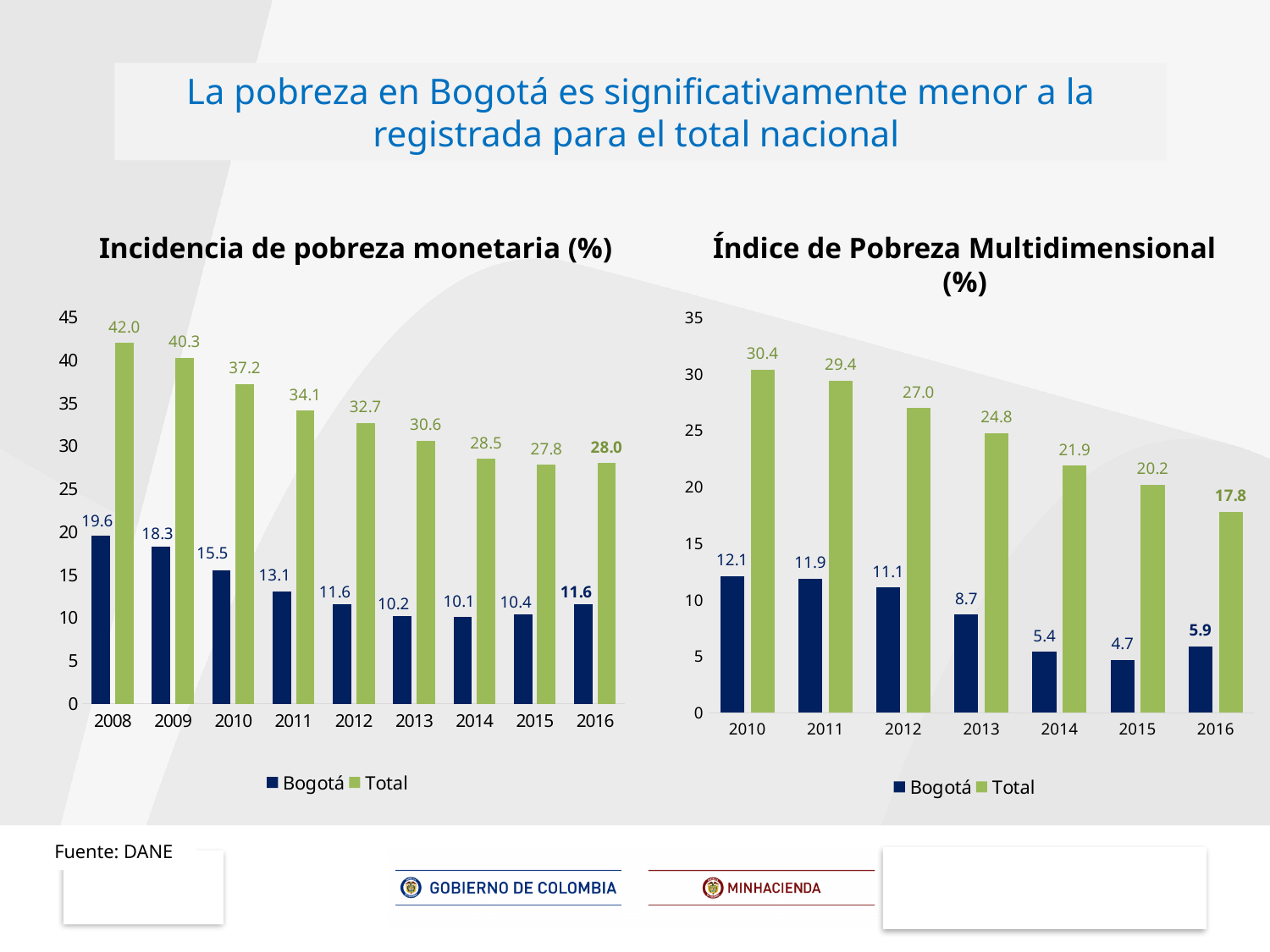
In the 'Incidencia de pobreza monetaria (%)' chart, which year has the highest Total value? 2008 In the 'Incidencia de pobreza monetaria (%)' chart, which year has the lowest Bogotá value? 2014 In the 'Índice de Pobreza Multidimensional (%)' chart, what is the value for Bogotá in 2013? 8.7 In the 'Incidencia de pobreza monetaria (%)' chart, how many years are shown on the x axis? 9 In the 'Incidencia de pobreza monetaria (%)' chart, what is the value for Bogotá in 2008? 19.6 In the 'Índice de Pobreza Multidimensional (%)' chart, do the Total values rise or fall from 2010 to 2016? fall In the 'Incidencia de pobreza monetaria (%)' chart, what is the Total value for 2016? 28.0 In the 'Índice de Pobreza Multidimensional (%)' chart, is the Bogotá value for 2016 larger or smaller than the Bogotá value for 2015? larger In the 'Índice de Pobreza Multidimensional (%)' chart, how many series does the legend list? 2 In the 'Índice de Pobreza Multidimensional (%)' chart, which year has the lowest Bogotá value? 2015 In the 'Índice de Pobreza Multidimensional (%)' chart, what is the Total value for 2010? 30.4 In the 'Incidencia de pobreza monetaria (%)' chart, what is the difference between the Total and Bogotá values in 2012? 21.1